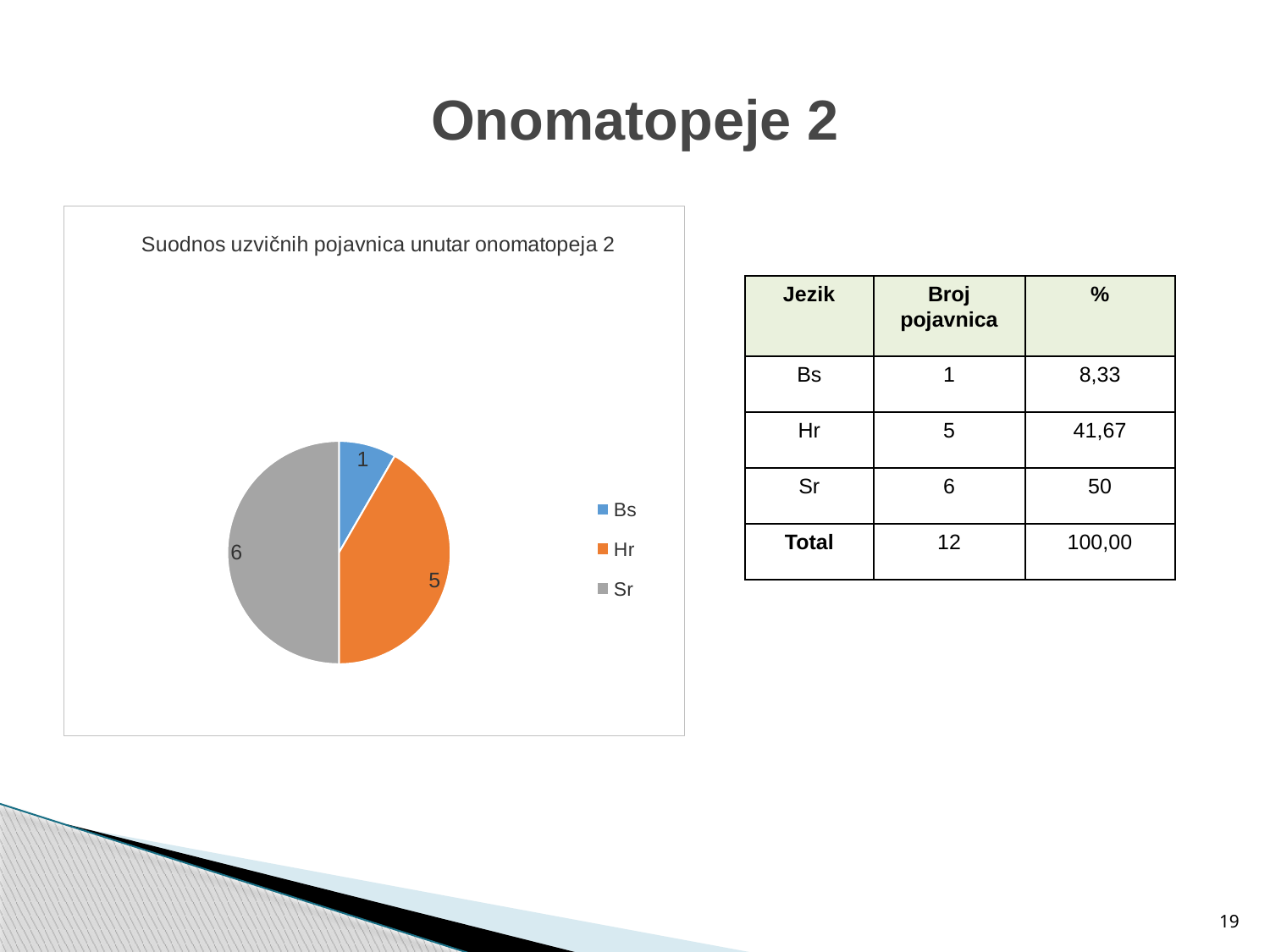
What type of chart is shown on the slide? pie chart How many slices does the pie chart have? 3 Which category has the largest slice in the pie chart? Sr What is the value for Bs in the pie chart? 1 Which category has the smallest slice in the pie chart? Bs What is the difference between the values for Sr and Hr? 1 What share of the pie does Sr represent? 50% What is the title of the chart? Suodnos uzvičnih pojavnica unutar onomatopeja 2 What is the value for Sr in the pie chart? 6 Which is larger, the value for Hr or the value for Bs? Hr What is the value for Hr in the pie chart? 5 What is the difference between the values for Hr and Bs? 4